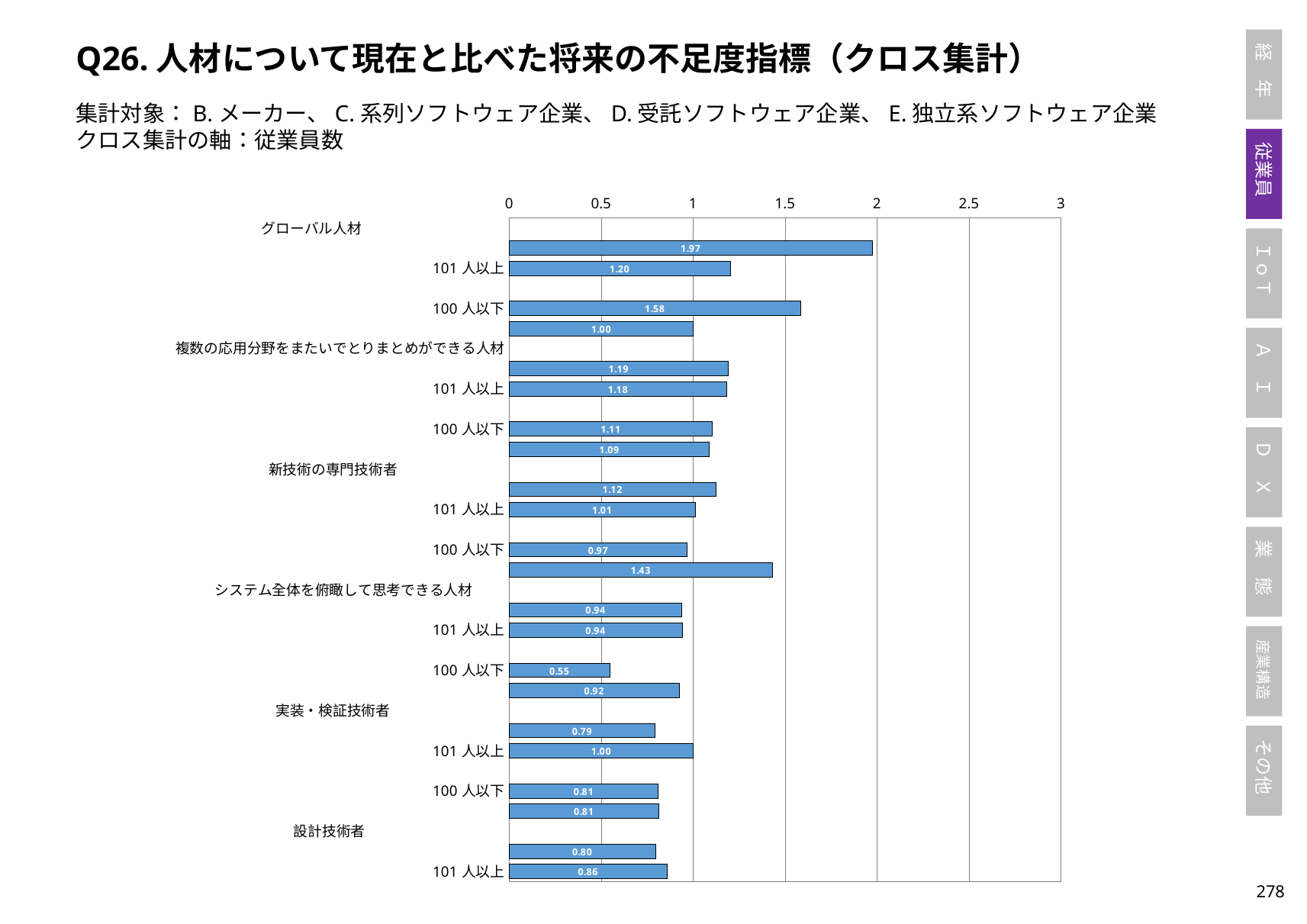
How many bars in the chart have a value above 1.5? 2 What is the difference between the highest bar value (1.97) and the lowest bar value (0.55)? 1.42 What is the lowest value printed on any bar in the chart? 0.55 What kind of chart is shown on the slide? bar chart What is the title of the slide containing the chart? Q26. 人材について現在と比べた将来の不足度指標（クロス集計） What is the maximum value shown on the horizontal axis of the chart? 3 Which is larger, the bar labelled 1.43 or the bar labelled 1.20? 1.43 What is the highest value printed on any bar in the chart? 1.97 Is the shortest bar in the chart greater or less than 1? less What is the second-highest value printed on a bar in the chart? 1.58 How many bars are plotted in the chart? 22 Is the longest bar in the chart greater or less than 1.5? greater